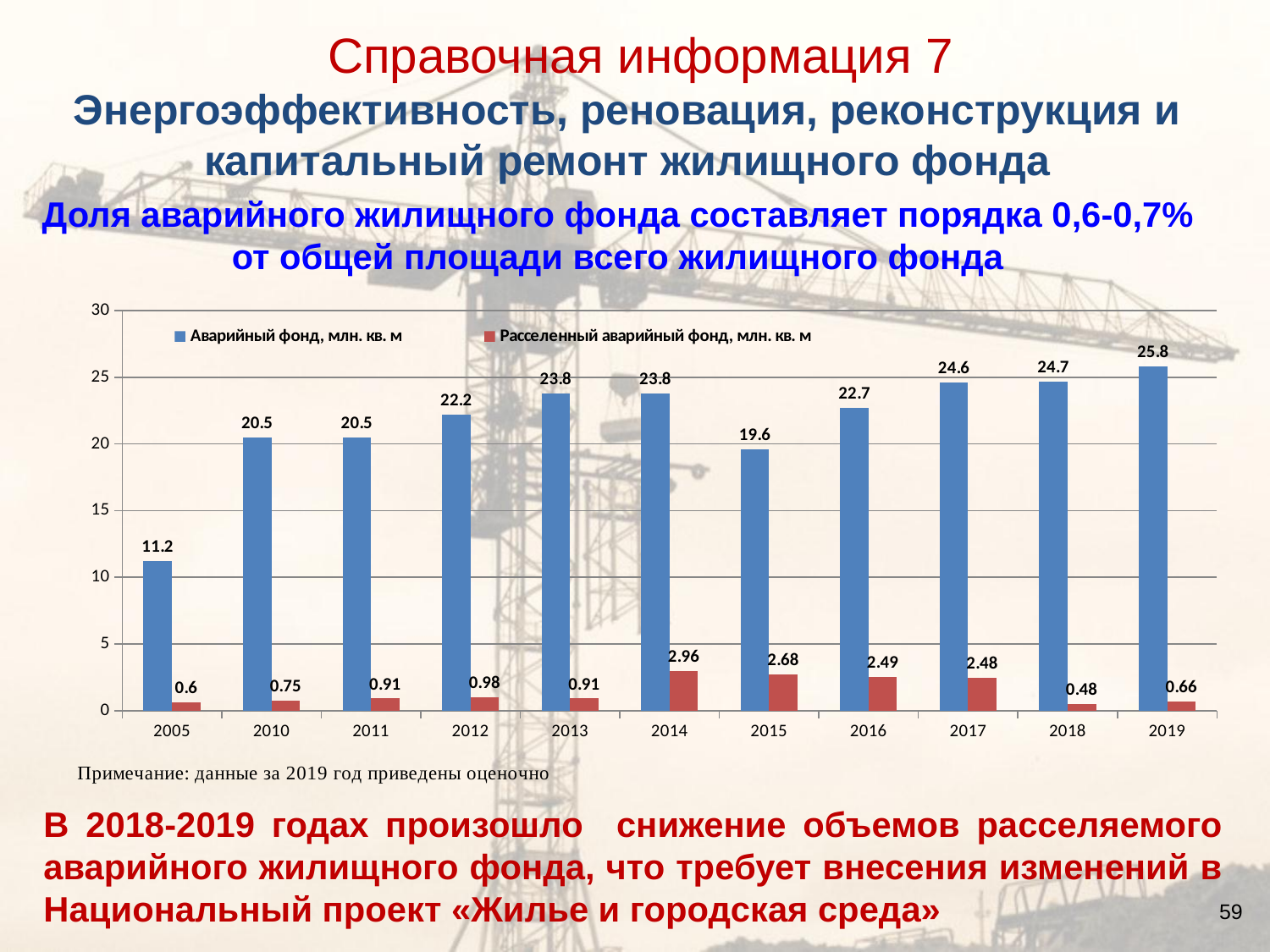
Which year has the highest value for "Расселенный аварийный фонд, млн. кв. м"? 2014 Which is larger: the "Аварийный фонд, млн. кв. м" value for 2015 or for 2016? 2016 Which year has the lowest value for "Расселенный аварийный фонд, млн. кв. м"? 2018 Is the value of "Аварийный фонд, млн. кв. м" for 2017 greater or less than 20? greater What kind of chart is shown on the slide? bar chart How many series does the chart legend list? 2 What is the difference between the "Аварийный фонд, млн. кв. м" values for 2019 and 2005? 14.6 What is the value of "Расселенный аварийный фонд, млн. кв. м" for 2014? 2.96 What is the value of "Аварийный фонд, млн. кв. м" for 2005? 11.2 Which year has the lowest value for "Аварийный фонд, млн. кв. м"? 2005 How many years are shown on the x axis of the chart? 11 What is the value of "Аварийный фонд, млн. кв. м" for 2019? 25.8